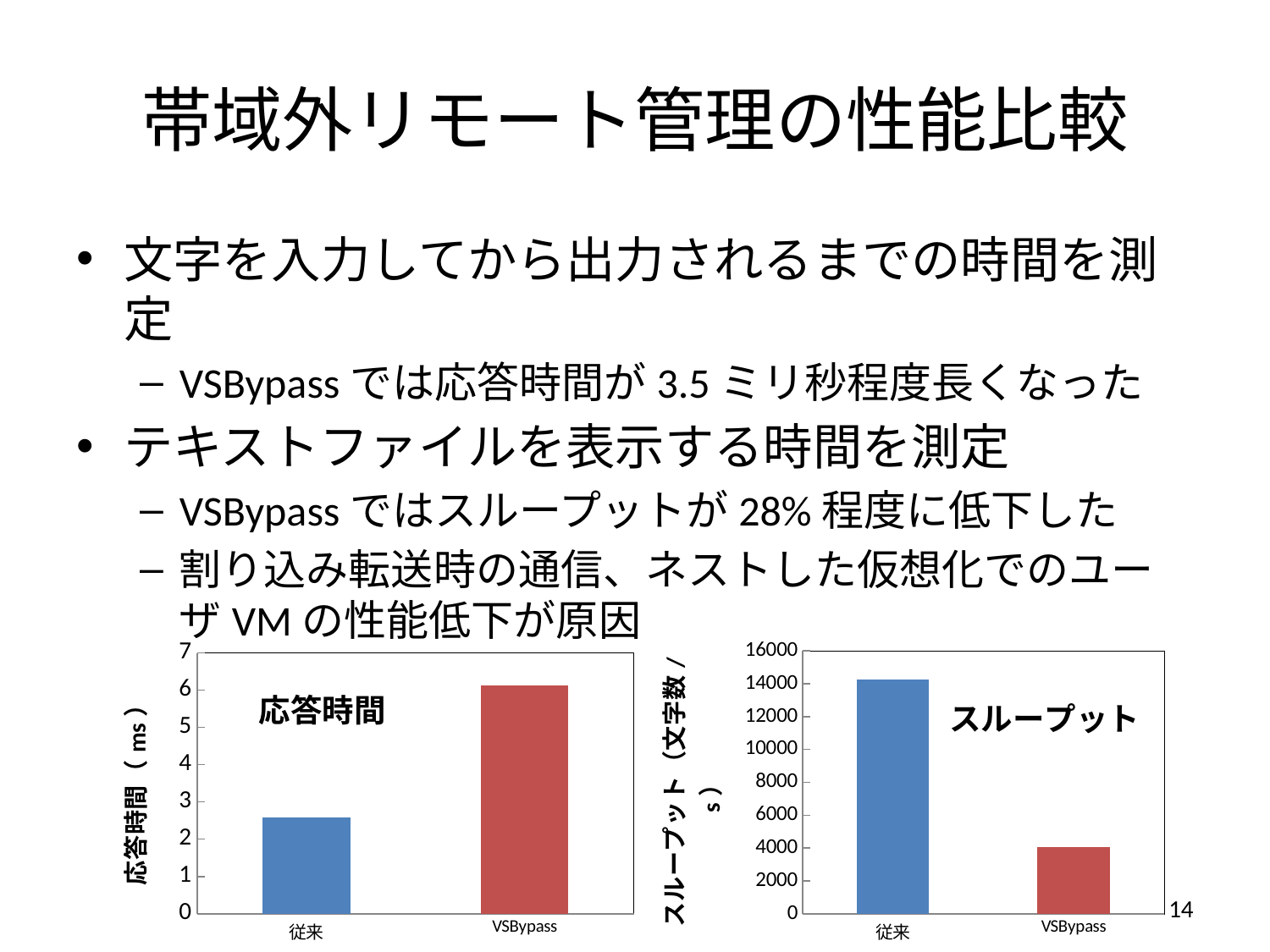
In the 応答時間 chart, is the value for VSBypass greater or less than 5? greater In the スループット chart, which category has the lower throughput? VSBypass What kind of chart is the 応答時間 chart? bar chart In the スループット chart, is the value for 従来 greater or less than 12000? greater In the 応答時間 chart, is the bar for 従来 taller or shorter than the bar for VSBypass? shorter How many categories are shown in the スループット chart? 2 In the 応答時間 chart, which category has the lower response time? 従来 In the 応答時間 chart, which category has the higher response time? VSBypass In the スループット chart, which category has the higher throughput? 従来 In the スループット chart, is the value for VSBypass greater or less than 6000? less What is the y-axis label of the 応答時間 chart? 応答時間（ms）